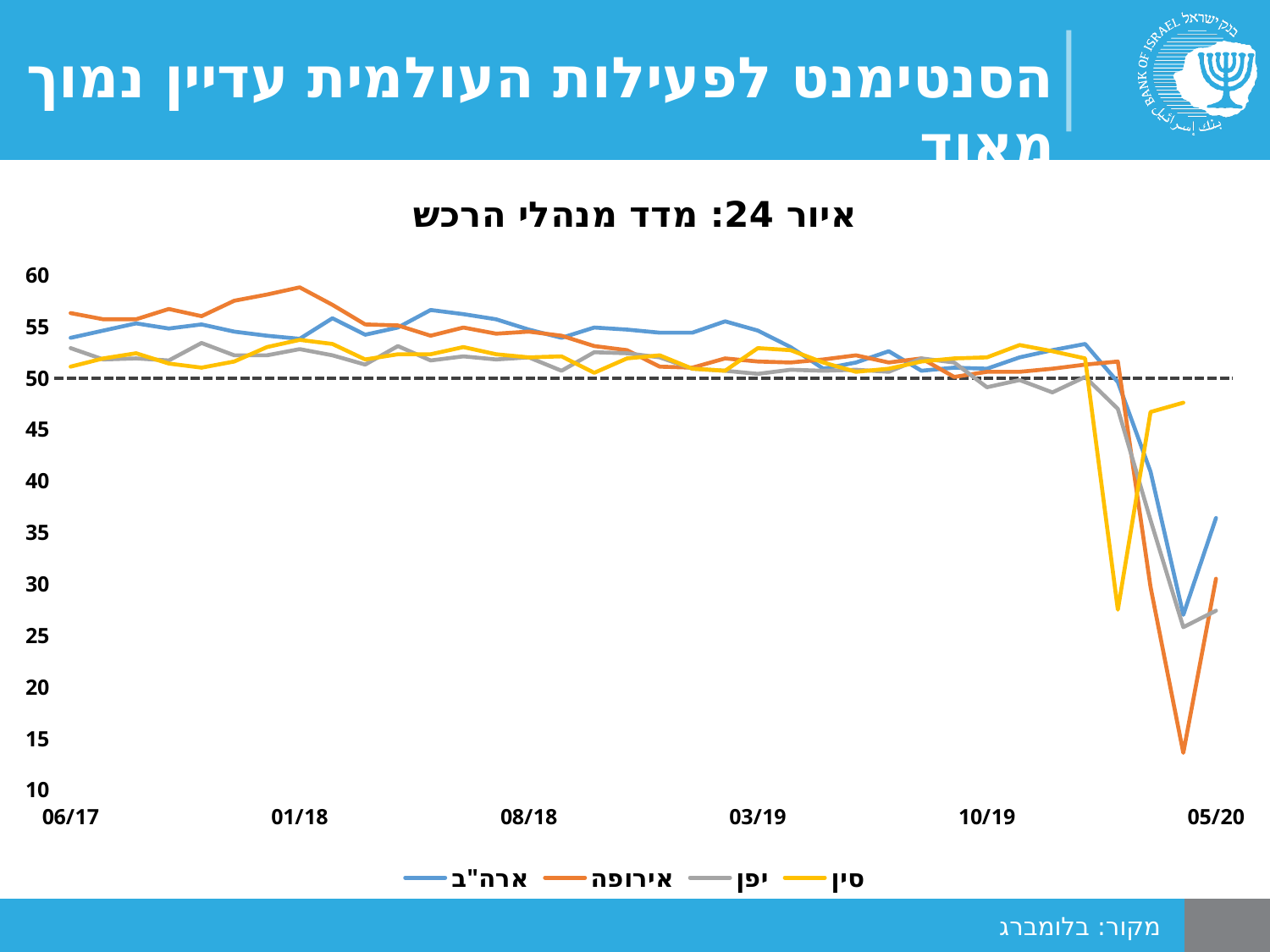
At what value is the dashed horizontal reference line drawn? 50 Is the lowest value of the אירופה series greater or less than 20? less What kind of chart is shown on the slide? line chart Which series has the highest value around 01/18? אירופה Which series reaches the lowest value on the chart? אירופה How many series does the legend list? 4 Overall, do the series rise or fall between 06/17 and 05/20? fall Is the lowest value of the סין series greater or less than 30? less Is the value for אירופה at 06/17 greater or less than 55? greater What is the title of the chart? איור 24: מדד מנהלי הרכש At the last point (05/20), is the value for ארה"ב higher or lower than the value for אירופה? higher